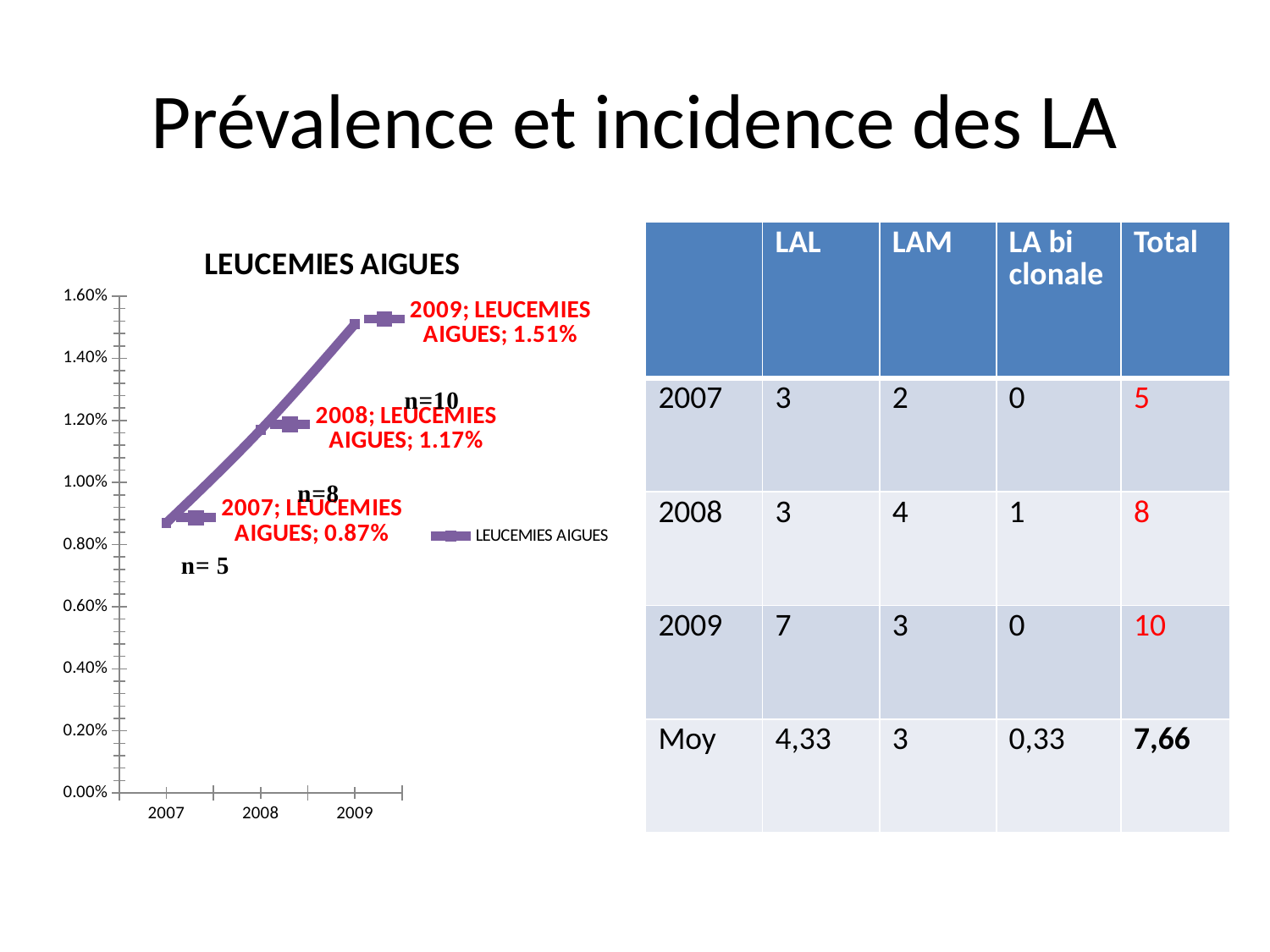
What is the value for 2007 in the LEUCEMIES AIGUES chart? 0.87% Which year has the highest value in the LEUCEMIES AIGUES chart? 2009 Is the value for 2008 in the LEUCEMIES AIGUES chart greater or less than 1.00%? greater What is the value for 2008 in the LEUCEMIES AIGUES chart? 1.17% Which year has the lowest value in the LEUCEMIES AIGUES chart? 2007 Do the values in the LEUCEMIES AIGUES chart rise or fall from 2007 to 2009? rise What is the difference between the 2008 and 2007 values in the LEUCEMIES AIGUES chart? 0.30% How many years are plotted in the LEUCEMIES AIGUES chart? 3 What is the difference between the 2009 and 2007 values in the LEUCEMIES AIGUES chart? 0.64% What kind of chart is the LEUCEMIES AIGUES chart? line chart In the LEUCEMIES AIGUES chart, which is larger, the value for 2008 or the value for 2009? 2009 What is the value for 2009 in the LEUCEMIES AIGUES chart? 1.51%